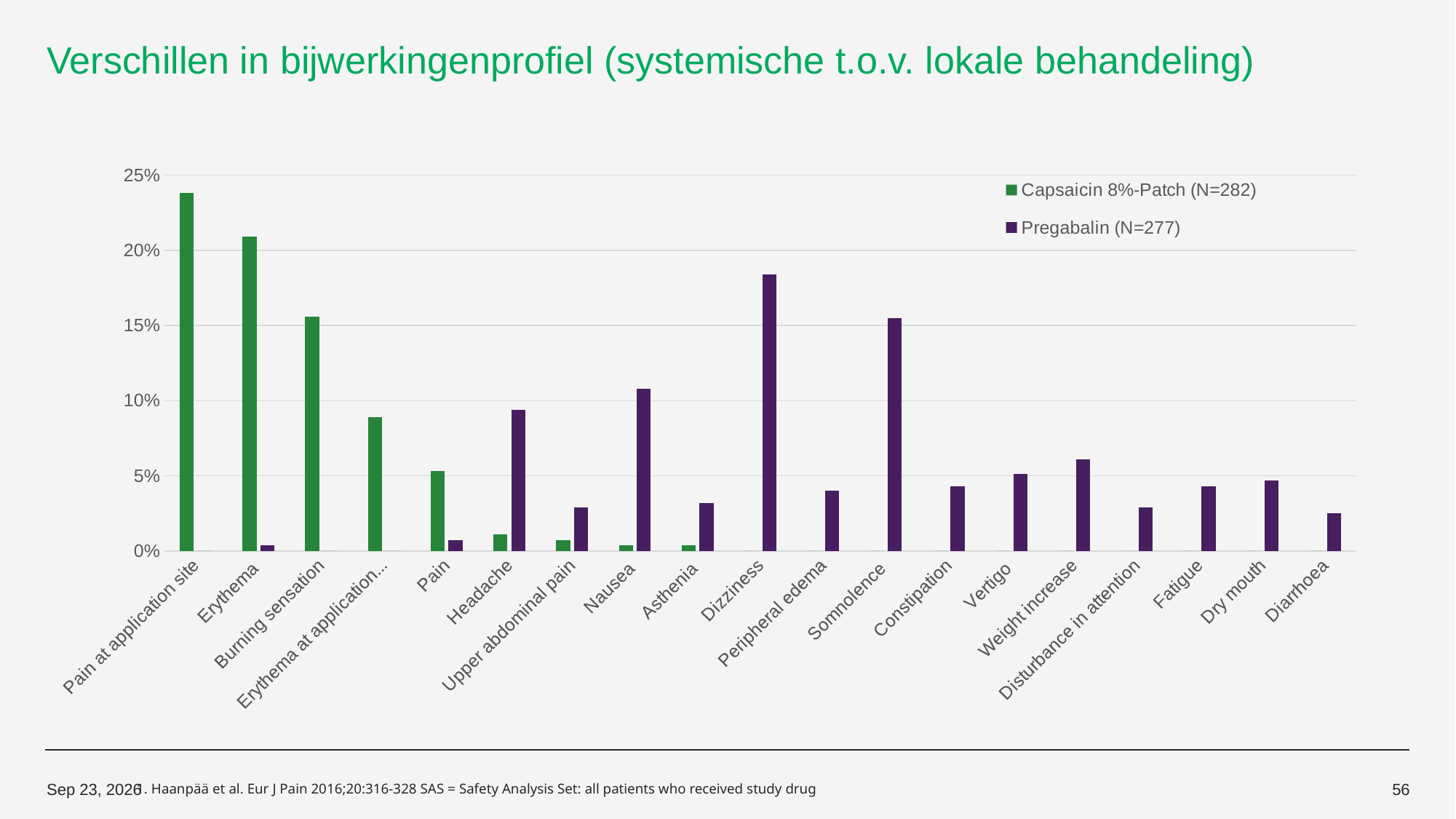
How many adverse-event categories are shown on the x axis? 19 Is the Pregabalin value for Nausea greater or less than 10%? greater What colour are the bars for Pregabalin (N=277)? purple For Pregabalin, which is larger: the value for Dizziness or the value for Somnolence? Dizziness For Headache, which series has the larger value, Capsaicin 8%-Patch or Pregabalin? Pregabalin Is the Pregabalin value for Somnolence greater or less than 15%? greater What kind of chart is shown on the slide? bar chart How many series does the legend list? 2 Which category has the highest value for Pregabalin (N=277)? Dizziness Which category has the highest value for Capsaicin 8%-Patch (N=282)? Pain at application site Is the Capsaicin 8%-Patch value for Erythema greater or less than 20%? greater